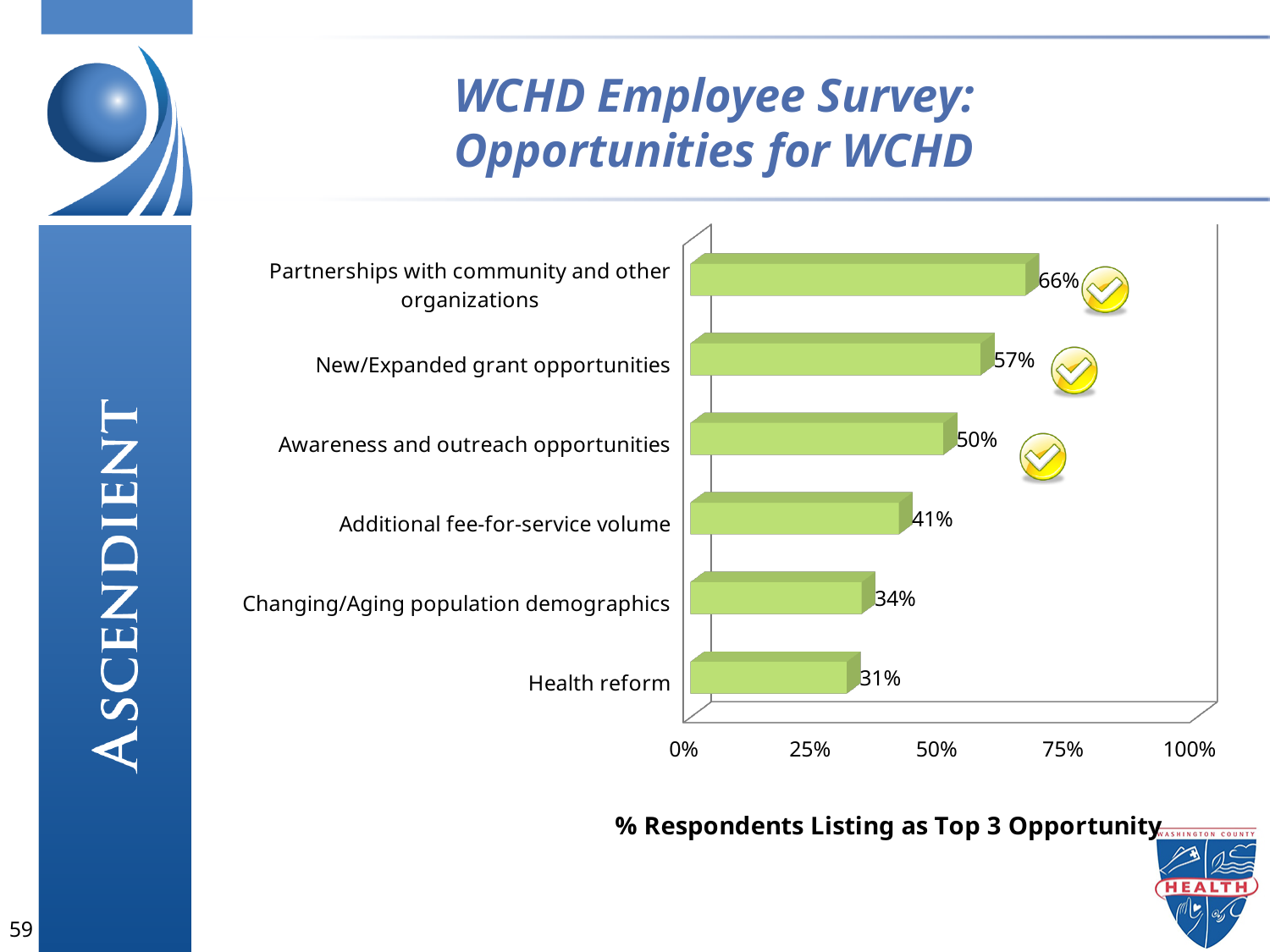
Is the value for Additional fee-for-service volume greater or less than 50%? less What is the difference between the values for New/Expanded grant opportunities and Additional fee-for-service volume? 16% Which opportunity has the lowest percentage of respondents? Health reform How many opportunity categories are shown in the chart? 6 What is the label shown below the x axis of the chart? % Respondents Listing as Top 3 Opportunity What is the value for Awareness and outreach opportunities? 50% What is the difference between the highest and lowest values in the chart? 35% What is the value for Health reform? 31% What kind of chart is shown on the slide? bar chart Which opportunity has the highest percentage of respondents? Partnerships with community and other organizations Which is larger: the value for Changing/Aging population demographics or the value for Health reform? Changing/Aging population demographics What percentage of respondents listed Partnerships with community and other organizations as a top 3 opportunity? 66%